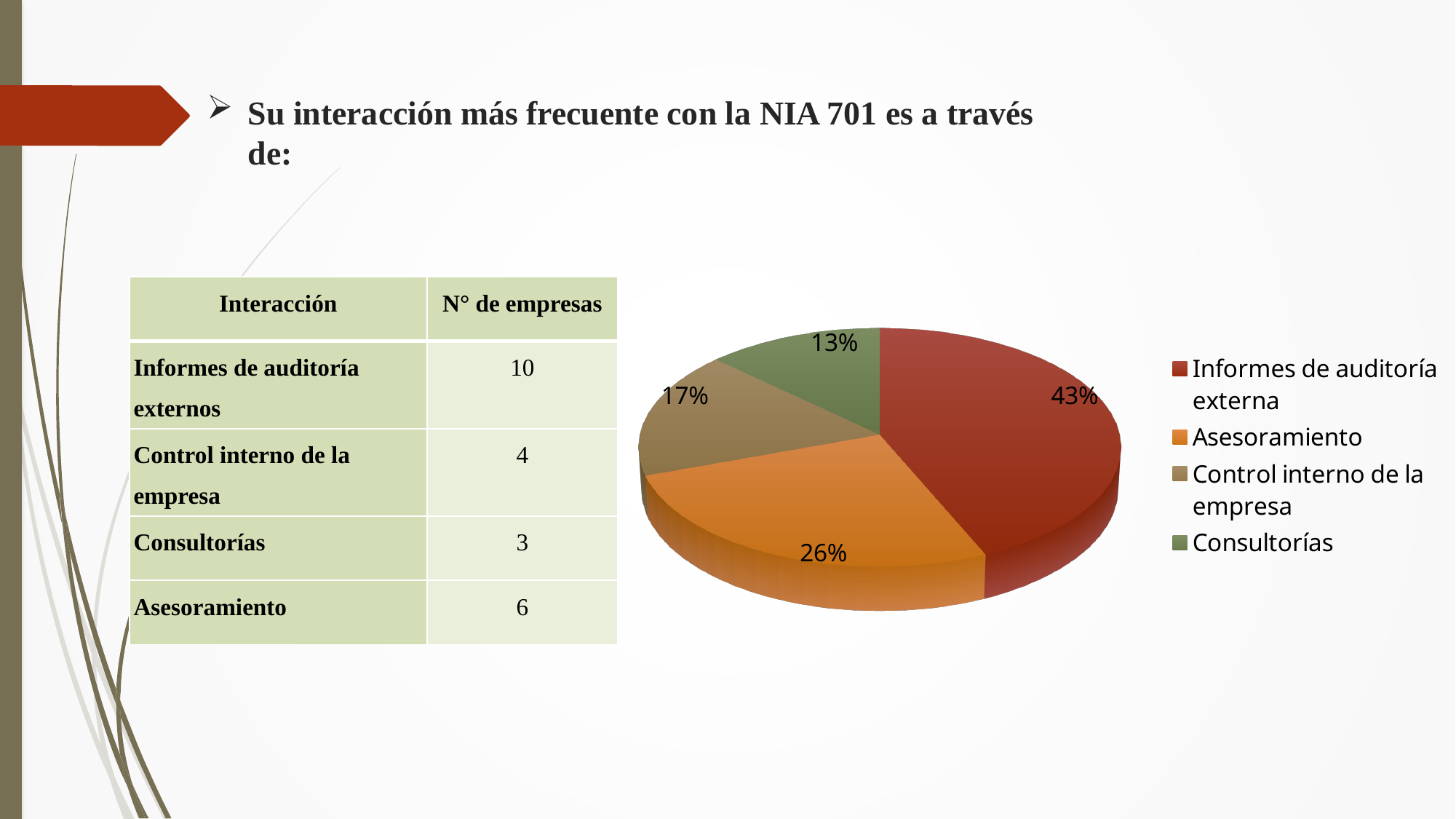
How many entries does the legend list? 4 Which category has the smallest slice of the pie? Consultorías What share of the pie does Control interno de la empresa represent? 17% What colour is the Consultorías slice in the pie chart? green What kind of chart is shown on the slide? pie chart What share of the pie does Informes de auditoría externa represent? 43% What share of the pie does Consultorías represent? 13% Which slice is larger, Asesoramiento or Control interno de la empresa? Asesoramiento Which category has the largest slice of the pie? Informes de auditoría externa How many slices does the pie chart have? 4 What is the difference in percentage points between the Informes de auditoría externa slice and the Asesoramiento slice? 17%